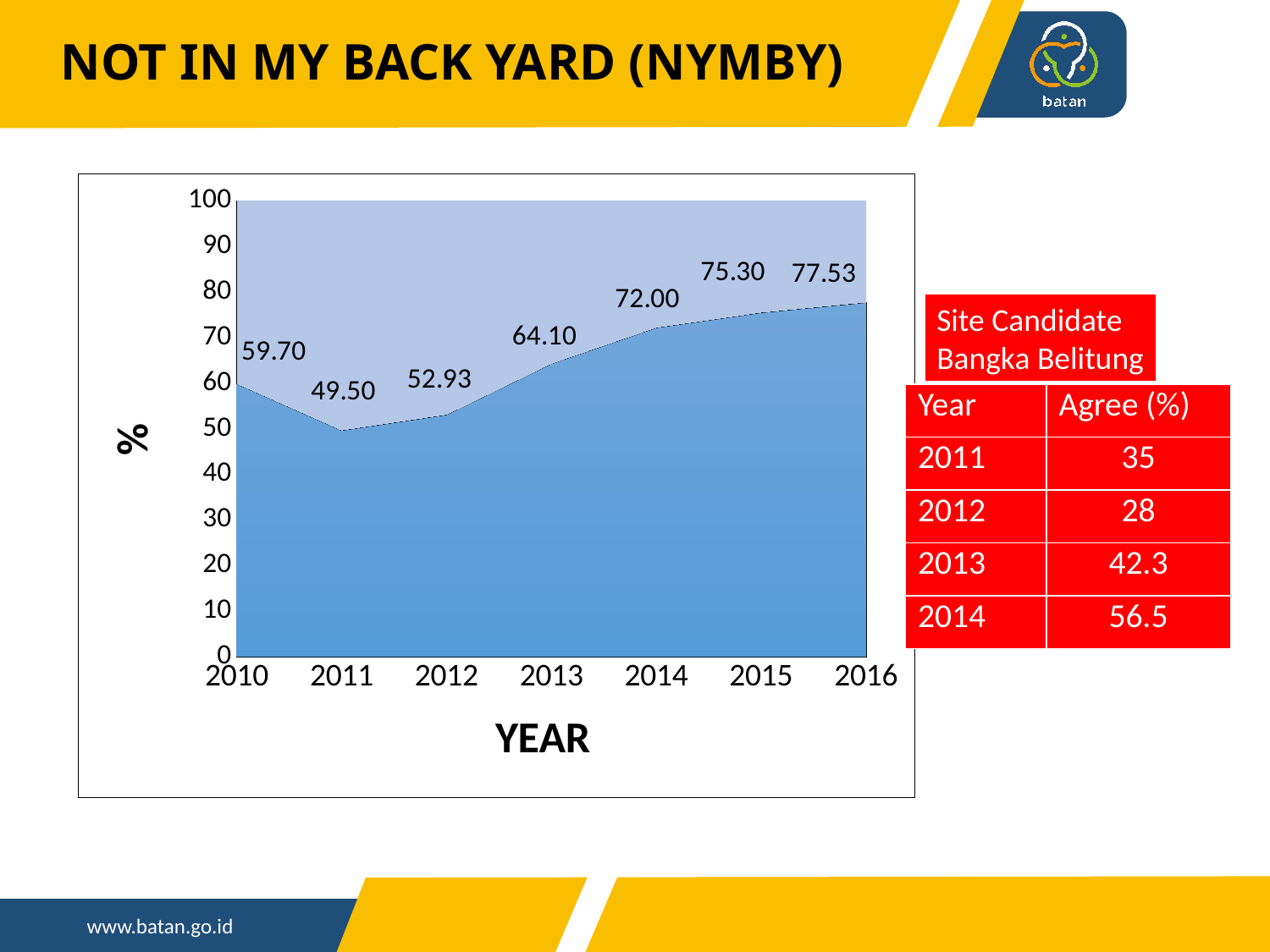
What is the value for 2016? 77.53 What is the label of the x axis? YEAR How many years are plotted on the x axis? 7 Which is larger, the value for 2012 or the value for 2010? 2010 What kind of chart is shown? area chart Is the value for 2015 greater or less than 70? greater What is the value for 2010? 59.70 Which year has the highest value? 2016 What is the value for 2013? 64.10 What is the difference between the values for 2016 and 2010? 17.83 Which year has the lowest value? 2011 What is the difference between the values for 2014 and 2013? 7.90